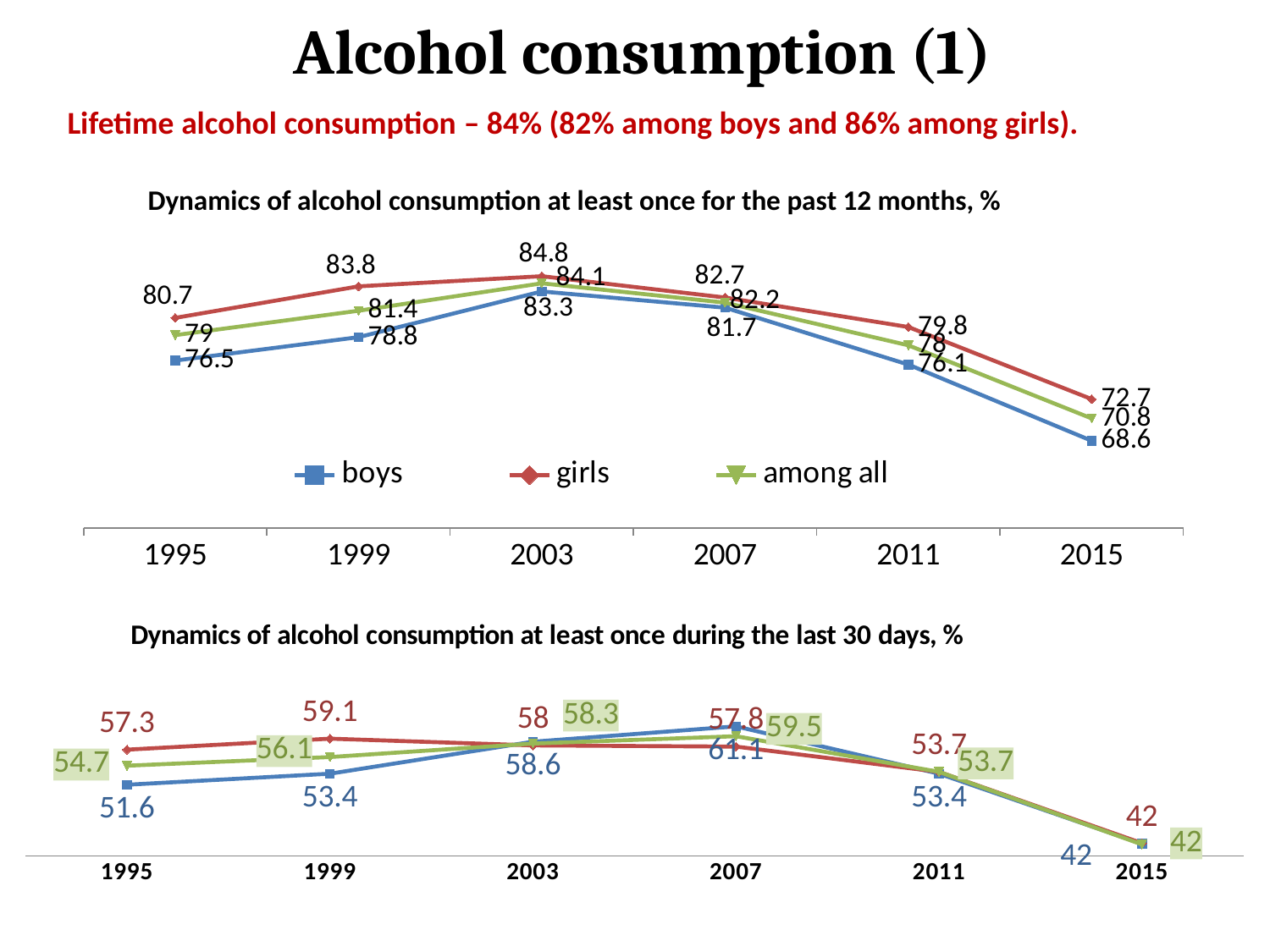
What kind of chart is 'Dynamics of alcohol consumption at least once during the last 30 days, %'? Line chart In the chart 'Dynamics of alcohol consumption at least once for the past 12 months, %', how many series does the legend list? 3 In the chart 'Dynamics of alcohol consumption at least once for the past 12 months, %', in which year is the value for boys highest? 2003 In the chart 'Dynamics of alcohol consumption at least once for the past 12 months, %', how do the values for boys change from 2003 to 2015? They fall In the chart 'Dynamics of alcohol consumption at least once during the last 30 days, %', what value do all three lines reach in 2015? 42 In the chart 'Dynamics of alcohol consumption at least once for the past 12 months, %', in which year is the value for girls lowest? 2015 In the chart 'Dynamics of alcohol consumption at least once for the past 12 months, %', what is the value for boys in 2015? 68.6 In the chart 'Dynamics of alcohol consumption at least once for the past 12 months, %', what is the value for 'among all' in 1999? 81.4 In the chart 'Dynamics of alcohol consumption at least once for the past 12 months, %', what is the difference between the girls and boys values in 1995? 4.2 In the chart 'Dynamics of alcohol consumption at least once for the past 12 months, %', what is the value for girls in 2003? 84.8 In the chart 'Dynamics of alcohol consumption at least once during the last 30 days, %', how many years are shown on the x axis? 6 In the chart 'Dynamics of alcohol consumption at least once during the last 30 days, %', what is the value of the blue line in 2007? 61.1